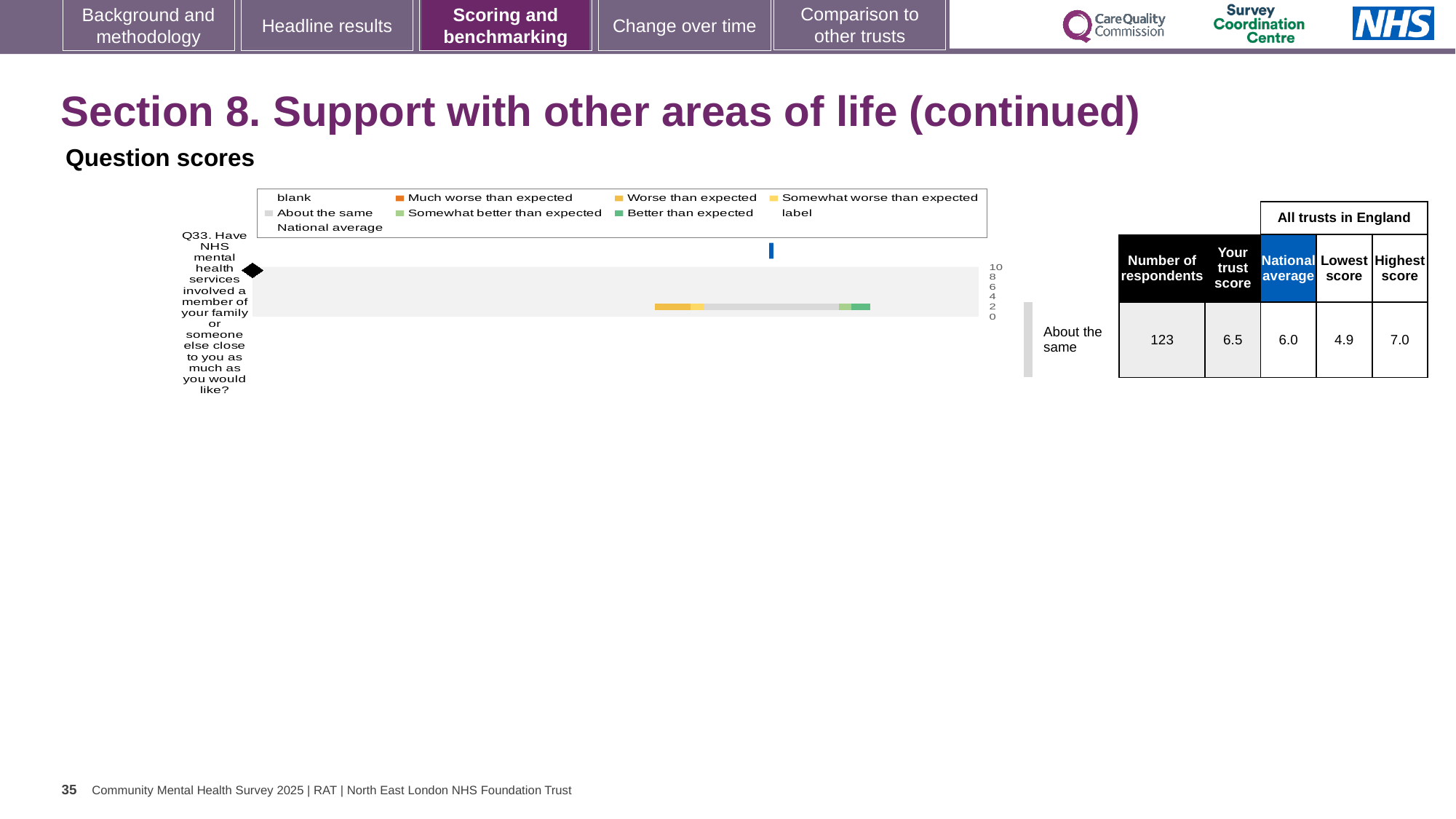
What kind of chart is used to show the Q33 question score? bar chart What is the national average score for Q33? 6.0 Which is larger for Q33, the trust score or the national average? the trust score How many entries does the chart legend list? 9 By how much does the trust score for Q33 exceed the national average? 0.5 What is the lowest score among all trusts in England for Q33? 4.9 What is the trust score for Q33 shown in the table beside the chart? 6.5 What is the highest score among all trusts in England for Q33? 7.0 How many questions are plotted on the chart? 1 What benchmark category is the trust's Q33 score placed in? About the same What is the difference between the highest and lowest trust scores for Q33? 2.1 How many respondents answered Q33? 123